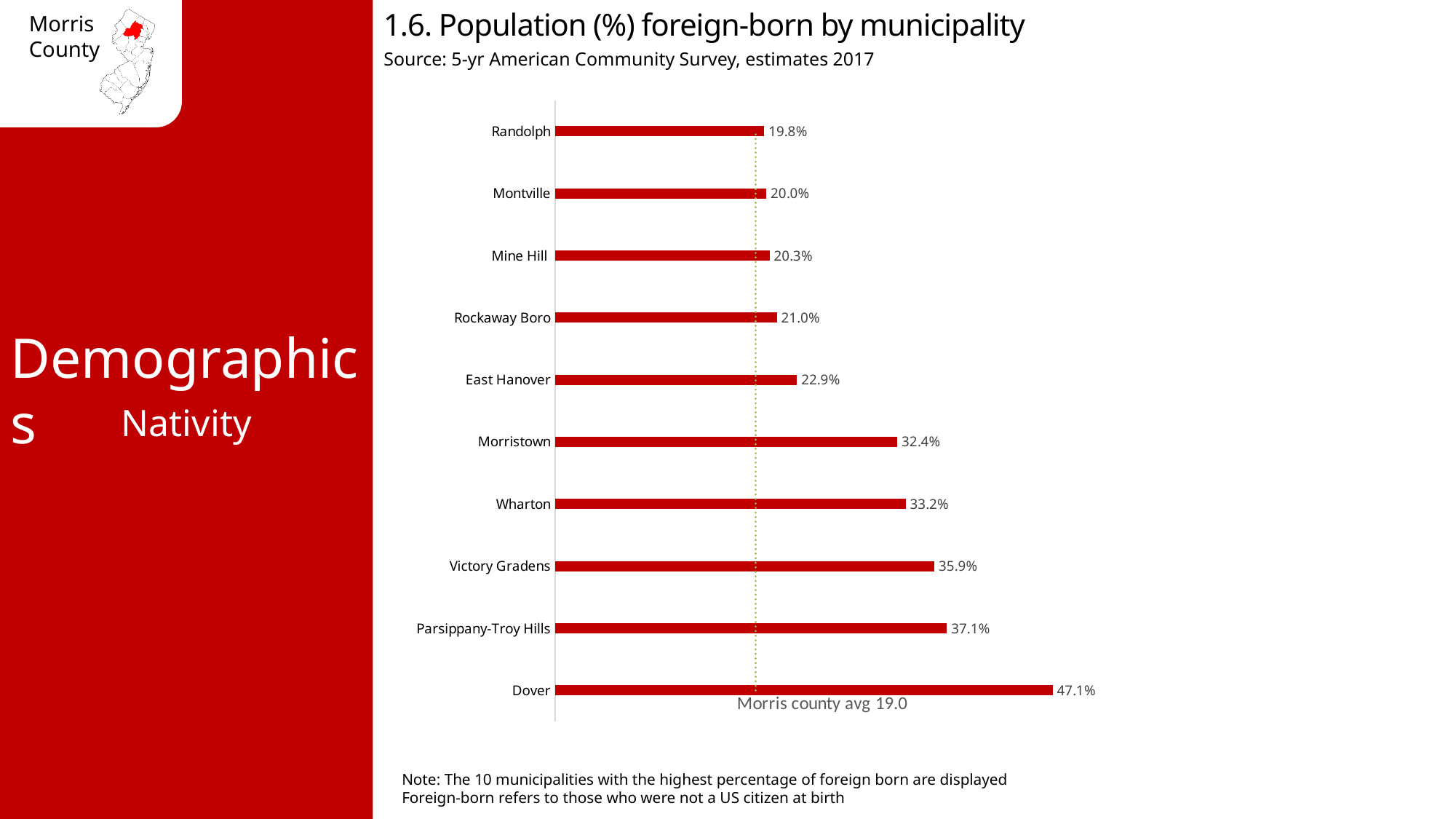
Which municipality has the lowest percentage of foreign-born population on the chart? Randolph What kind of chart is used on this slide? Bar chart What is the source of the data shown in the chart? 5-yr American Community Survey, estimates 2017 What is the difference in foreign-born percentage between Dover and Parsippany-Troy Hills? 10.0% What is the difference in foreign-born percentage between Wharton and Morristown? 0.8% Which municipality has the highest percentage of foreign-born population? Dover How many municipalities are shown on the chart? 10 What is the foreign-born population percentage for Randolph? 19.8% What is the foreign-born population percentage for Morristown? 32.4% Which has a higher foreign-born percentage, Victory Gradens or East Hanover? Victory Gradens What is the foreign-born population percentage for Dover? 47.1% What is the Morris county average foreign-born percentage indicated by the dotted line? 19.0